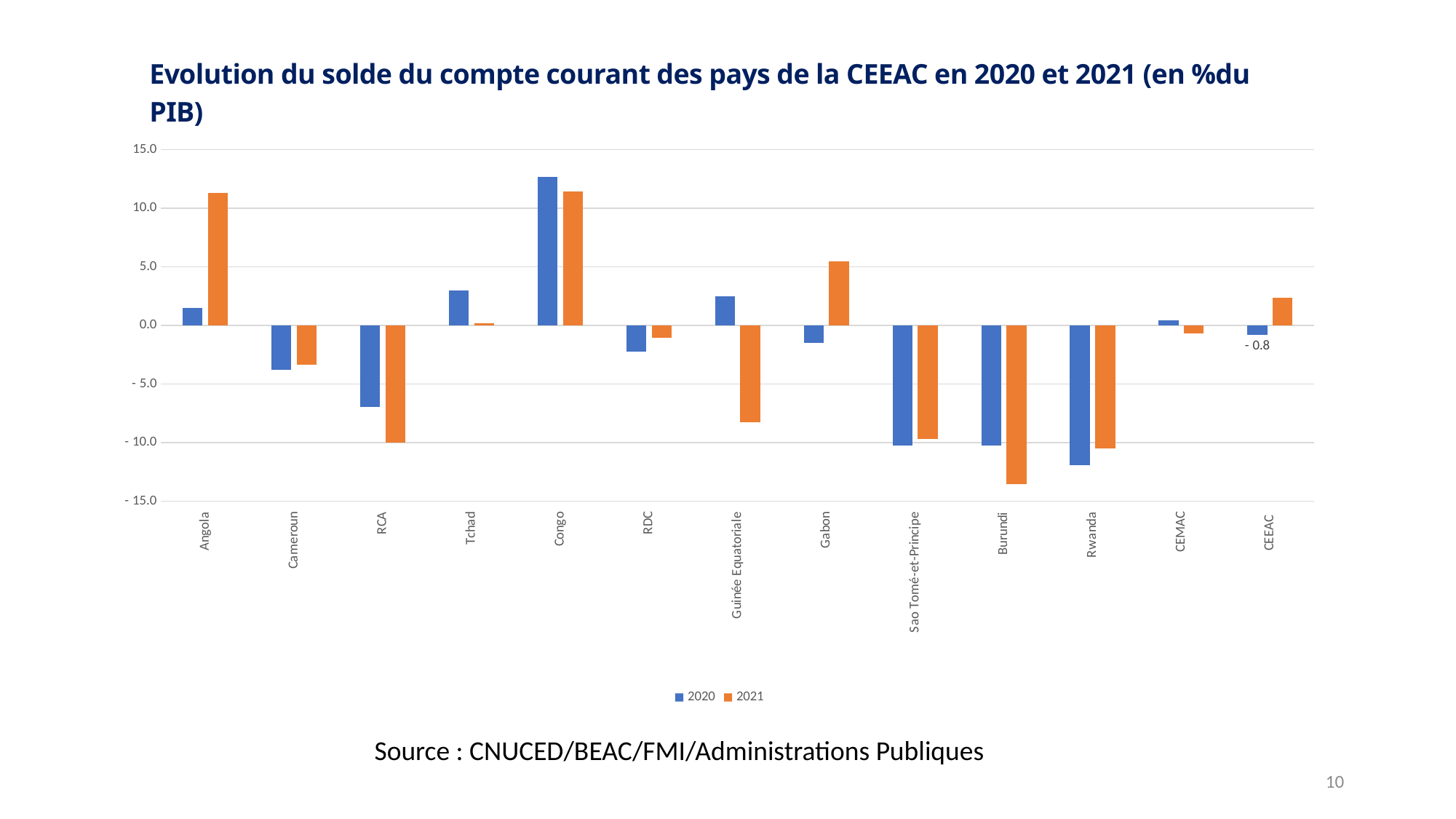
How many series does the legend list? 2 Is the value for Guinée Equatoriale in 2021 greater or less than -5.0? less Which category has the lowest value for 2020? Rwanda What are the two series named in the legend? 2020 and 2021 Is the value for Angola in 2021 greater or less than 10.0? greater For Guinée Equatoriale, which year has the larger value, 2020 or 2021? 2020 What is the value for CEEAC in 2020? - 0.8 Which category has the lowest value for 2021? Burundi Which category has the highest value for 2020? Congo For Angola, which year has the larger value, 2020 or 2021? 2021 How many categories are shown on the x axis? 13 What type of chart is shown on the slide? bar chart